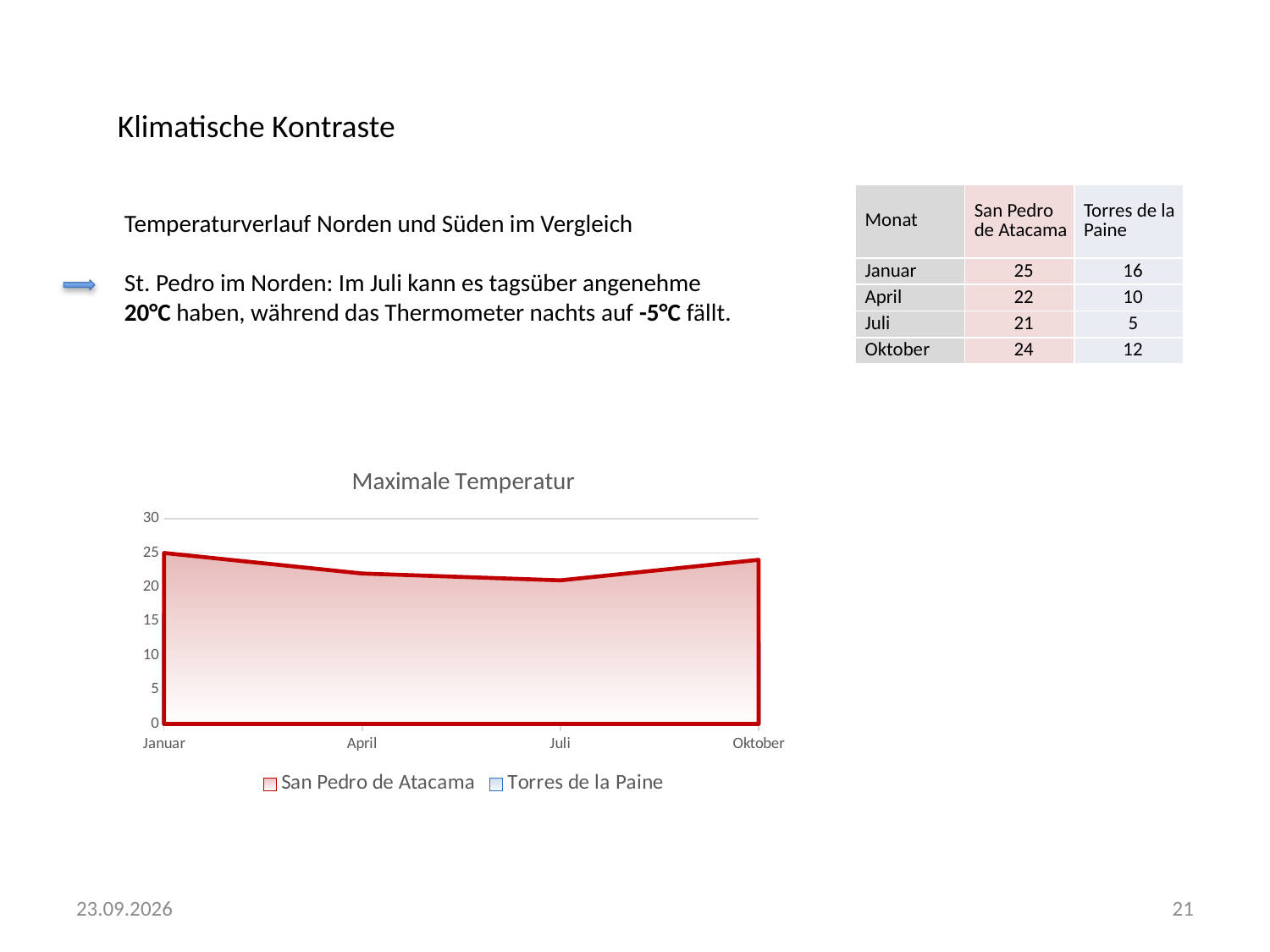
What is the maximum temperature for San Pedro de Atacama in Januar? 25 In which month is the San Pedro de Atacama value highest? Januar What is the maximum temperature for San Pedro de Atacama in Juli? 21 Which series are listed in the chart legend? San Pedro de Atacama and Torres de la Paine How many months are shown on the x axis of the chart? 4 Do the San Pedro de Atacama values rise or fall from Januar to Juli? fall What is the title of the chart? Maximale Temperatur Is the San Pedro de Atacama value for Juli greater or less than 25? less How many series does the chart legend list? 2 In which month is the San Pedro de Atacama value lowest? Juli What kind of chart is shown on the slide? area chart What is the difference between the San Pedro de Atacama values for Januar and Juli? 4